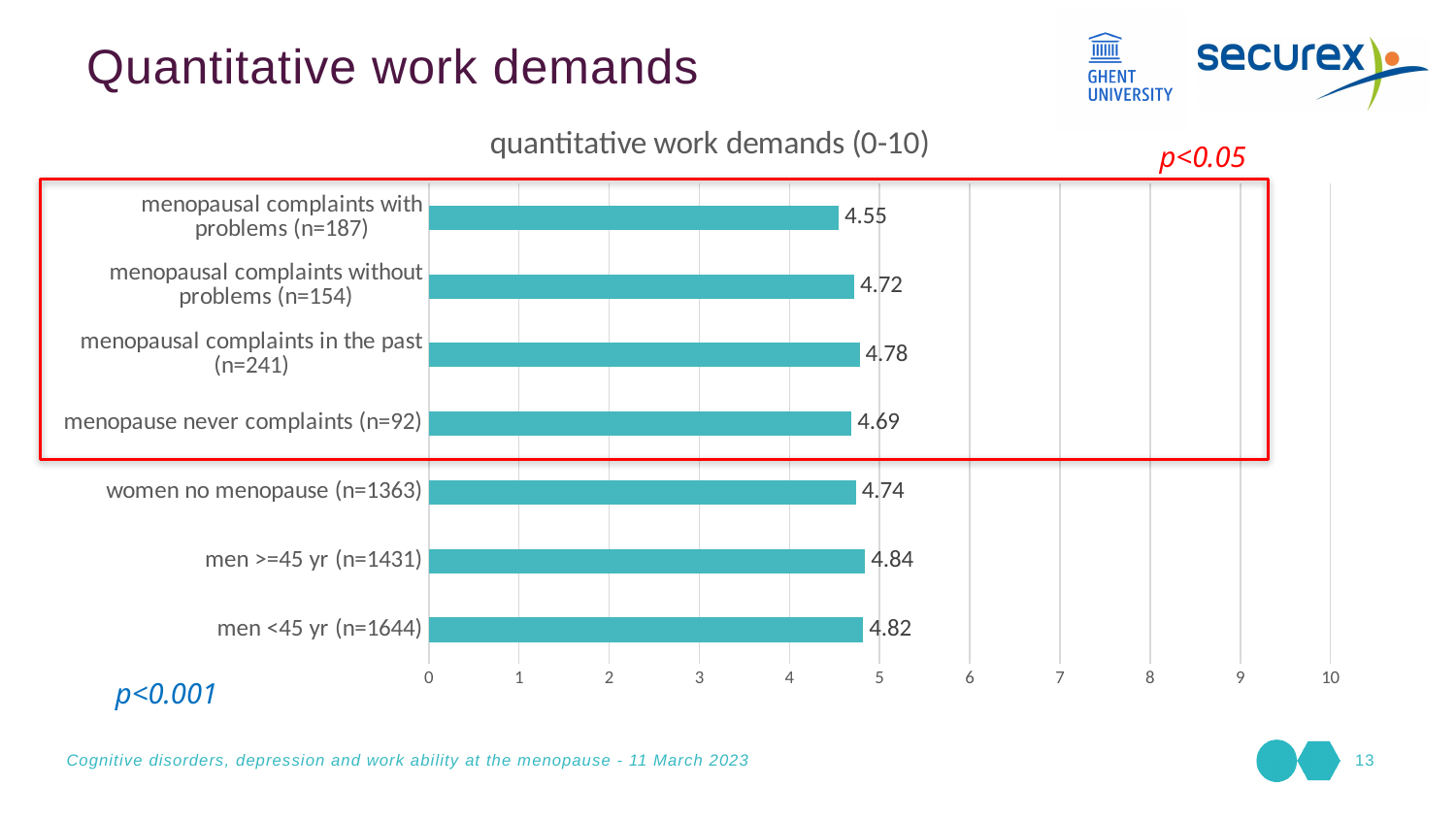
What is the value for women no menopause (n=1363)? 4.74 Which is larger: the value for menopausal complaints in the past (n=241) or menopause never complaints (n=92)? menopausal complaints in the past (n=241) Which category has the highest value? men >=45 yr (n=1431) What is the maximum value shown on the x axis? 10 How many categories are shown in the chart? 7 Is the value for men <45 yr (n=1644) greater or less than 5? less What is the title of the chart? quantitative work demands (0-10) What is the value for men >=45 yr (n=1431)? 4.84 What kind of chart is shown on the slide? bar chart What is the value for menopausal complaints with problems (n=187)? 4.55 Which category has the lowest value? menopausal complaints with problems (n=187) What is the difference between the values for men >=45 yr (n=1431) and menopausal complaints with problems (n=187)? 0.29